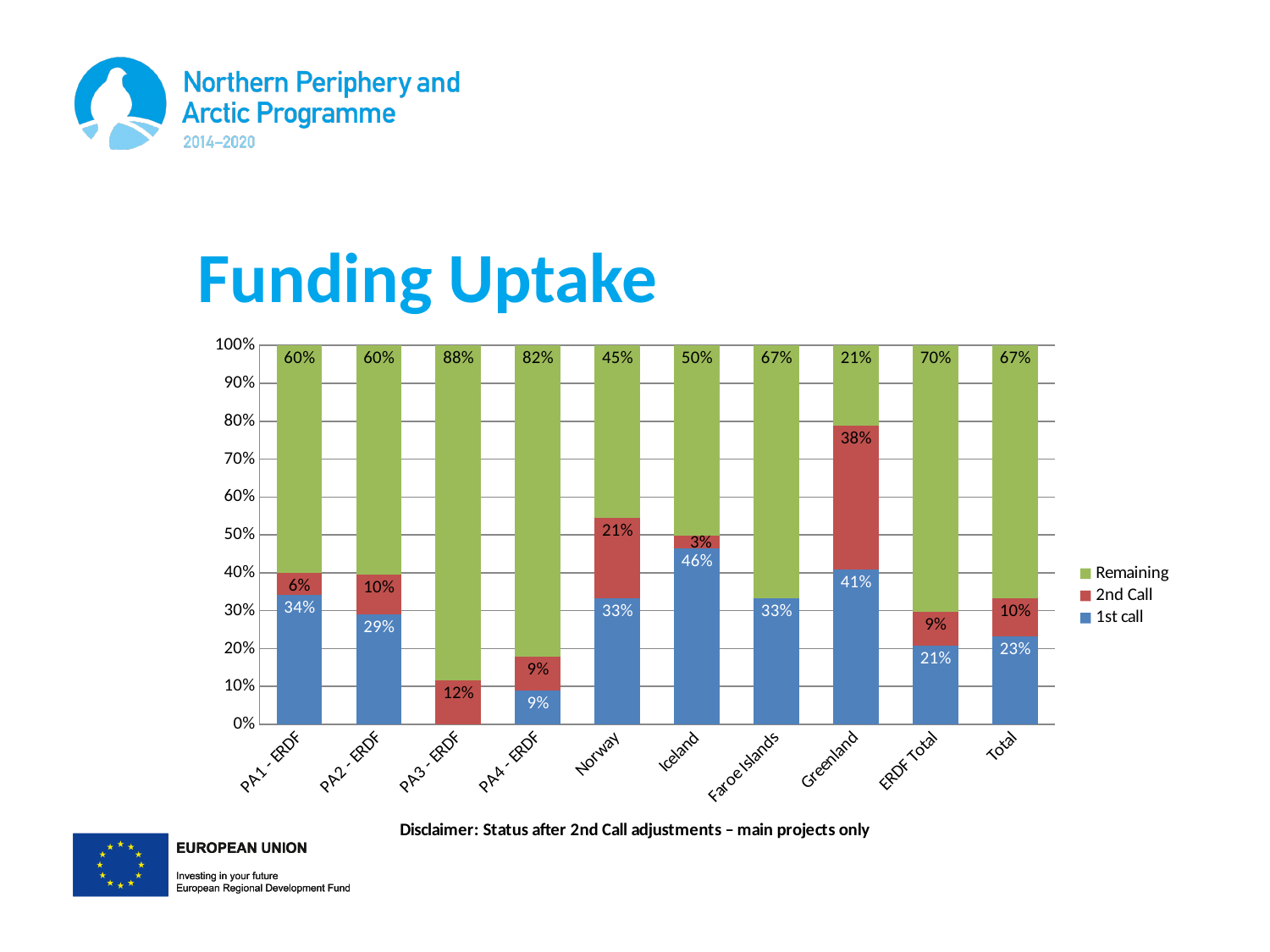
Which has a larger 1st call value, PA1 - ERDF or PA2 - ERDF? PA1 - ERDF What kind of chart is shown on the slide? Stacked bar chart What is the difference between the 2nd Call values for Norway and Iceland? 18% How many series does the legend list? 3 What is the 1st call value for ERDF Total? 21% What is the Remaining value for PA3 - ERDF? 88% What is the 2nd Call value for Greenland? 38% What is the 1st call value for Iceland? 46% How many categories are shown along the x axis? 10 What is the title of the chart? Funding Uptake Which category has the highest Remaining value? PA3 - ERDF Which category has the lowest Remaining value? Greenland